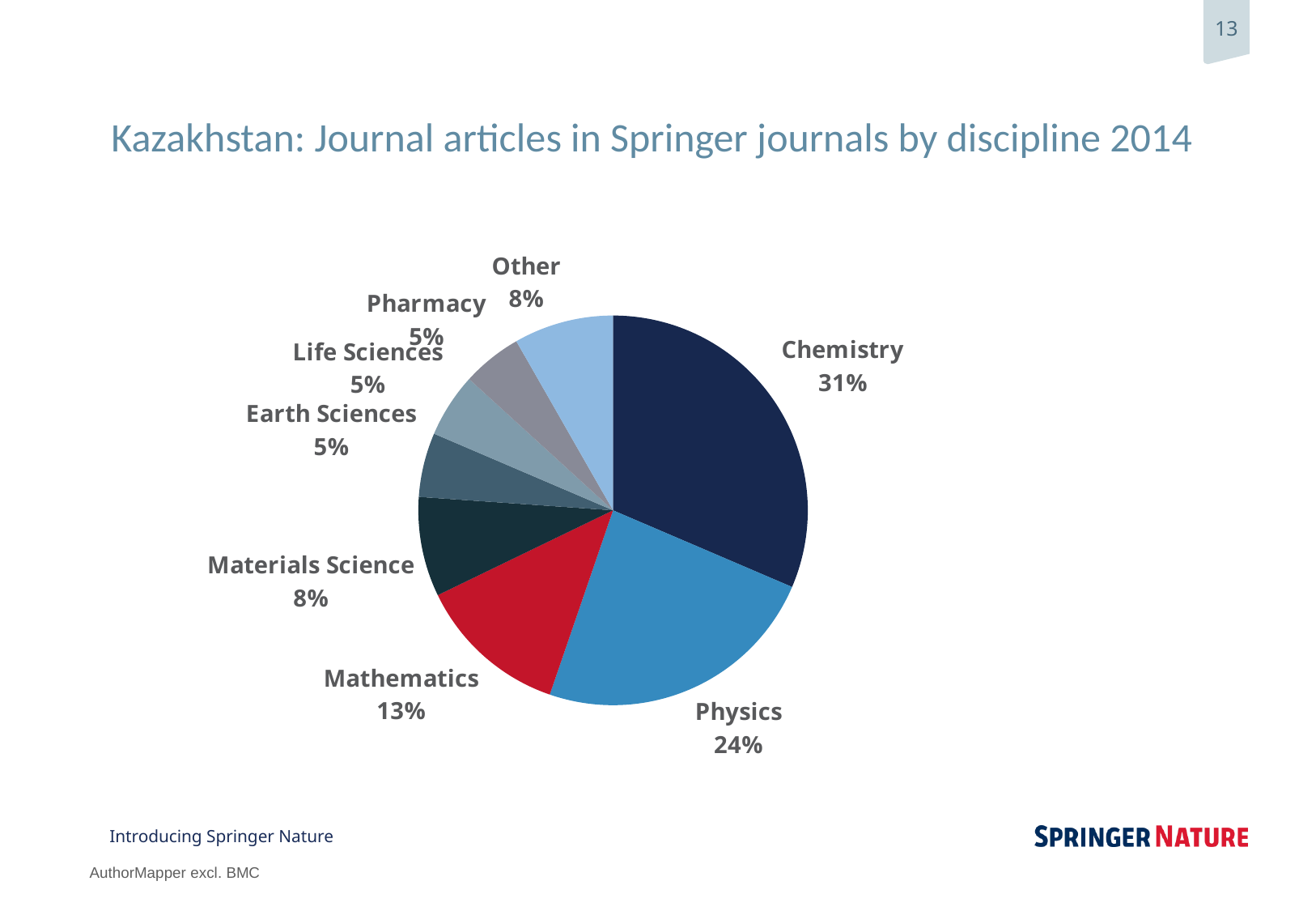
Which is larger, the share for Mathematics or the share for Materials Science? Mathematics What share of journal articles is Materials Science? 8% What is the title of the chart? Kazakhstan: Journal articles in Springer journals by discipline 2014 What share of journal articles is Chemistry? 31% What is the difference in percentage points between Chemistry and Physics? 7 What kind of chart is shown on the slide? pie chart How many slices does the pie chart have? 8 Which discipline has the largest share of the pie? Chemistry What is the combined share of Chemistry and Physics? 55% What share of journal articles is Pharmacy? 5% What share of journal articles is Mathematics? 13% What share of journal articles is Physics? 24%